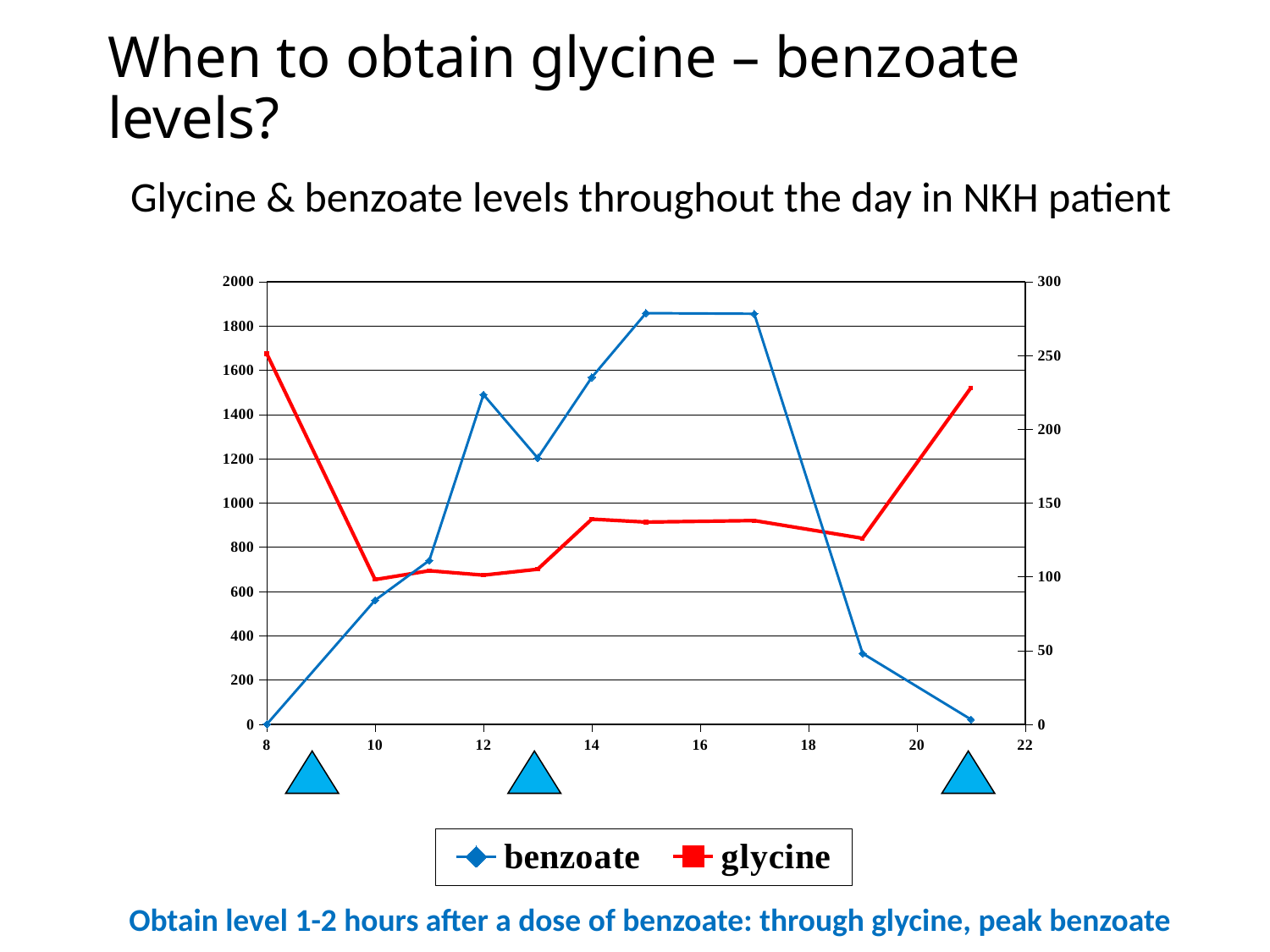
What colour is the glycine line in the chart? red Which is larger, the benzoate value at x = 12 or at x = 13? x = 12 How many series does the legend list? 2 Is the glycine value at x = 8 greater or less than 200 on the right axis? greater What kind of chart is shown on the slide? line chart How many data points are plotted for the benzoate series? 10 Is the glycine value at x = 14 greater or less than 150 on the right axis? less Is the benzoate value at x = 12 greater or less than 1400? greater Does the benzoate line rise or fall between x = 17 and x = 21? fall Does the glycine line rise or fall between x = 8 and x = 10? fall